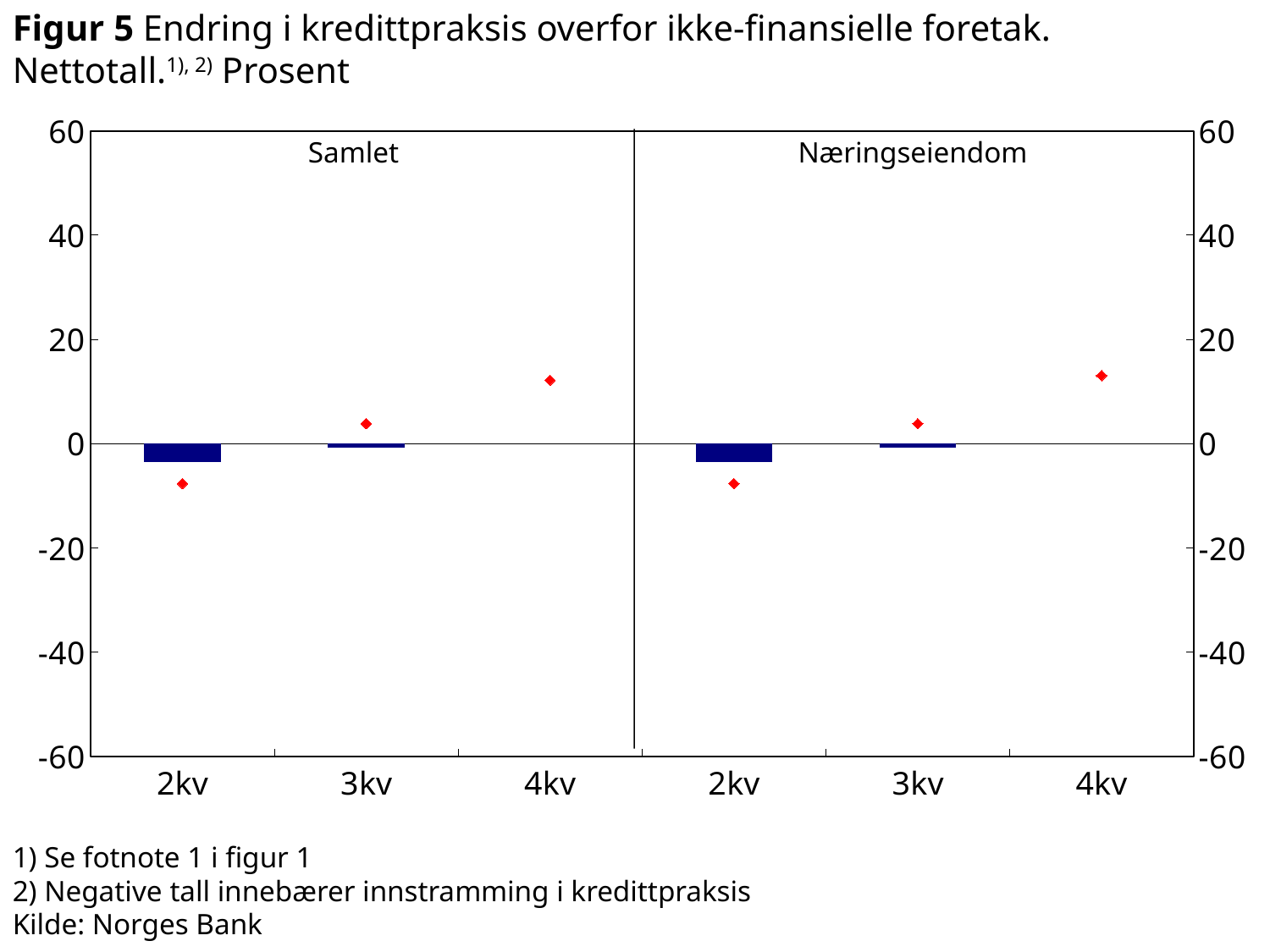
In the Samlet panel, which quarter has the lowest red marker? 2kv How many quarters are shown on the x axis of the Samlet panel? 3 What kind of chart is this? Bar chart with markers What are the two panel labels shown inside the chart? Samlet and Næringseiendom In the Samlet panel, is the red marker for 4kv greater or less than 20? less In the Samlet panel, is the blue bar for 2kv greater or less than 0? less In the Samlet panel, do the red markers rise or fall from 2kv to 4kv? rise In the Næringseiendom panel, is the red marker for 4kv greater or less than 20? less In the Næringseiendom panel, which has the higher red marker, 3kv or 4kv? 4kv What is the maximum value shown on the y axis? 60